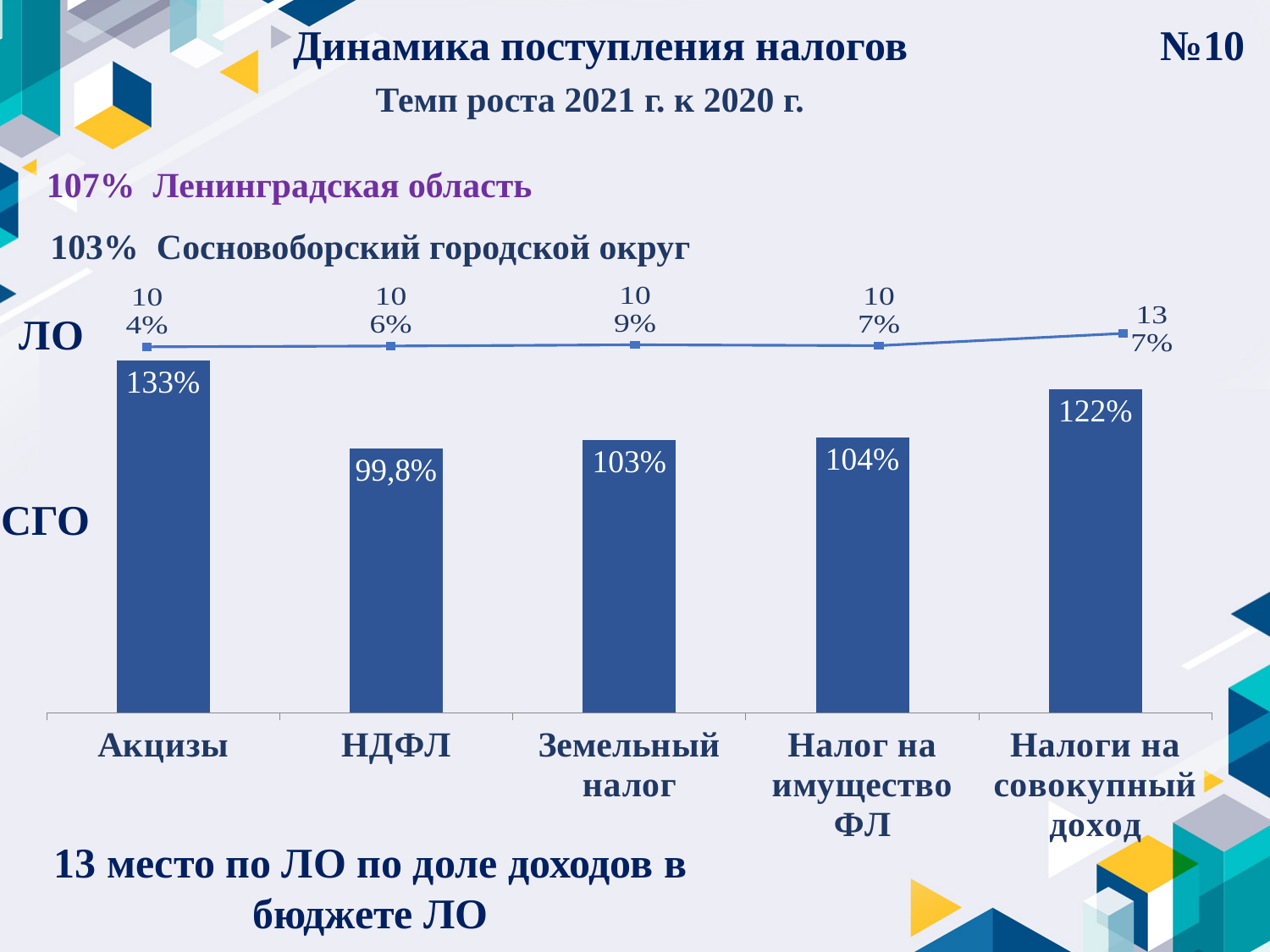
How many data series does the chart show? 2 Which category has the highest СГО bar? Акцизы What is the ЛО value for Земельный налог? 109% What is the difference between the СГО values for Акцизы and Налоги на совокупный доход? 11% Which category has the lowest СГО bar? НДФЛ How many categories are shown on the x axis? 5 Which is larger, the СГО value for Земельный налог or for Налог на имущество ФЛ? Налог на имущество ФЛ What is the ЛО value for Налоги на совокупный доход? 137% What kind of chart is this? Combined bar and line chart What is the СГО value for НДФЛ? 99,8% What is the СГО value for Акцизы? 133% What is the СГО value for Налоги на совокупный доход? 122%